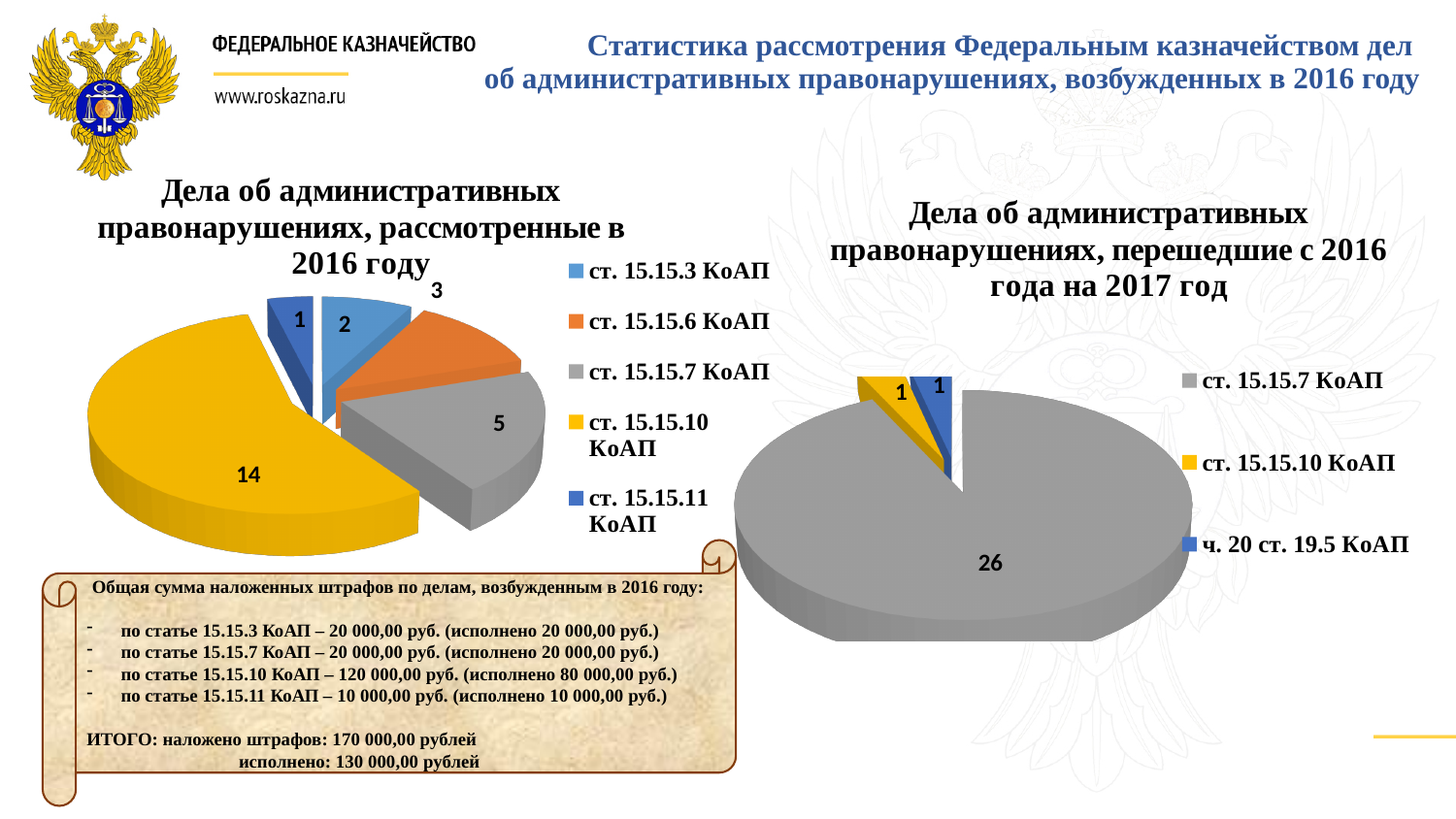
In the left chart (cases considered in 2016), what is the value for ст. 15.15.7 КоАП? 5 In the left chart (cases considered in 2016), what is the value for ст. 15.15.6 КоАП? 3 In the right chart (cases carried over from 2016 to 2017), how many categories does the legend list? 3 In the left chart (cases considered in 2016), what share of the total does ст. 15.15.10 КоАП represent? 56% In the left chart (cases considered in 2016), which category has the largest slice? ст. 15.15.10 КоАП In the right chart (cases carried over from 2016 to 2017), what is the value for ст. 15.15.7 КоАП? 26 What type of chart is used on the right side of the slide? Pie chart In the right chart (cases carried over from 2016 to 2017), which category has the largest slice? ст. 15.15.7 КоАП In the left chart (cases considered in 2016), which category has the smallest slice? ст. 15.15.11 КоАП In the left chart (cases considered in 2016), how many categories does the legend list? 5 In the left chart (cases considered in 2016), what is the difference between the values for ст. 15.15.10 КоАП and ст. 15.15.7 КоАП? 9 In the left chart (cases considered in 2016), what is the value for ст. 15.15.10 КоАП? 14